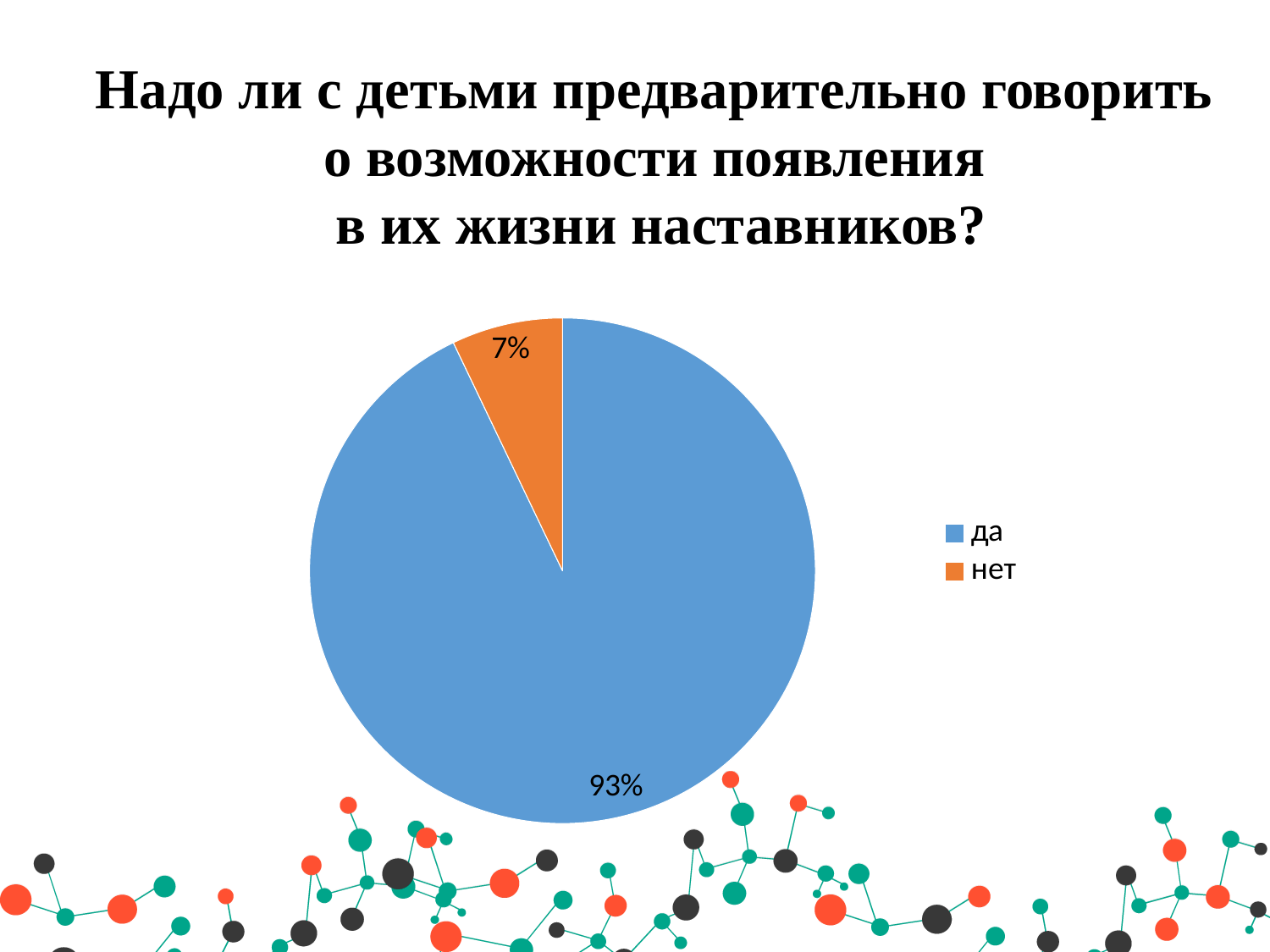
What colour is the "да" slice? blue What colour is the "нет" slice? orange Which category has the largest slice of the pie? да Which category has the smallest slice of the pie? нет What share of the pie does "нет" take? 7% What is the difference in percentage points between the "да" and "нет" slices? 86 How many entries does the legend list? 2 How many categories are shown in the pie chart? 2 Which is larger, the "да" slice or the "нет" slice? да What share of the pie does "да" take? 93% What kind of chart is shown on the slide? pie chart